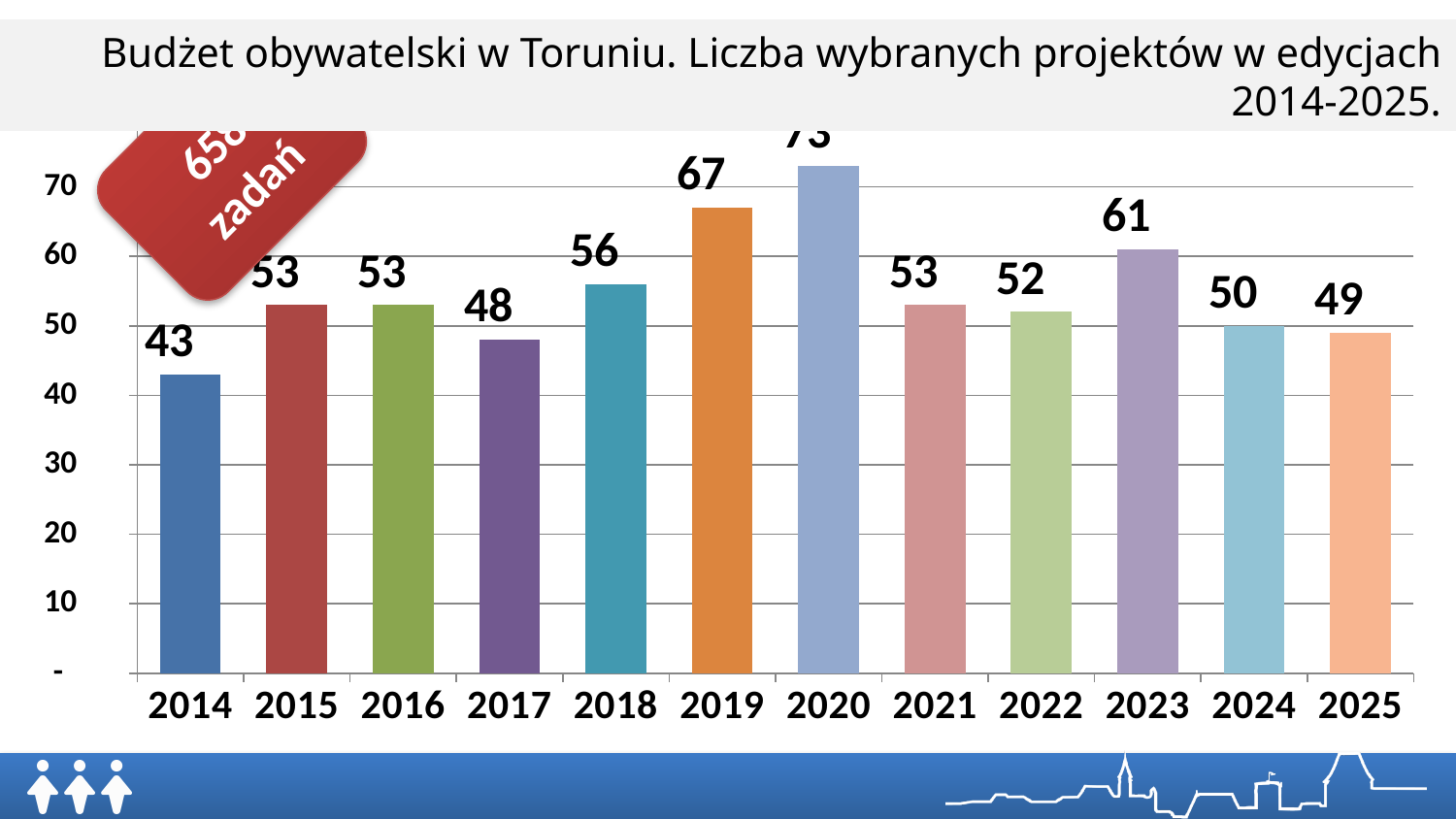
Which year has the lowest value? 2014 How many years (categories) are shown on the x axis of the chart? 12 What is the value for 2014? 43 What is the value for 2019? 67 What kind of chart is shown on the slide? bar chart Which is larger, the value for 2023 or the value for 2021? 2023 What is the value for 2017? 48 Do the values rise or fall from 2023 to 2025? fall Which year has the highest value? 2020 What is the value for 2023? 61 Is the value for 2020 greater or less than 70? greater What is the difference between the values for 2019 and 2018? 11